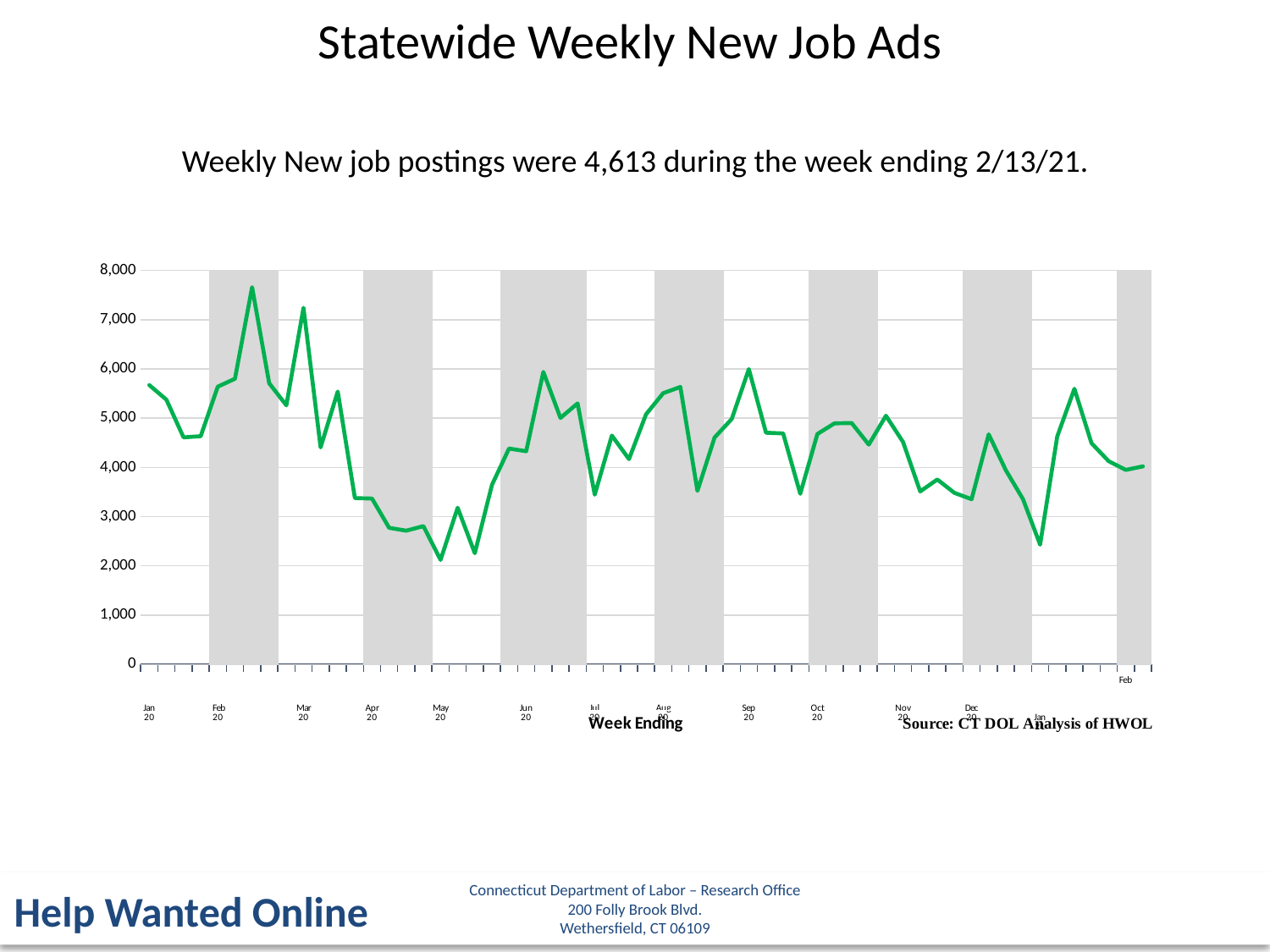
Is the lowest point in May 20 greater or less than 3,000? less Is the highest peak in Feb 20 greater or less than 7,000? greater What kind of chart is shown on the slide? line chart Is the value at the start of the line in Jan 20 greater or less than 5,000? greater What source is cited for the chart? CT DOL Analysis of HWOL In which month does the line reach its lowest point? May 20 Which is higher, the value at the start of the line in Jan 20 or the value at the end of the line in Feb 21? Jan 20 Do the values generally rise or fall between Mar 20 and May 20? fall What is the title of the x axis? Week Ending In which month does the line reach its highest peak? Feb 20 Which is higher, the peak in Feb 20 or the peak in Mar 20? Feb 20 According to the slide, how many weekly new job postings were there during the week ending 2/13/21? 4,613